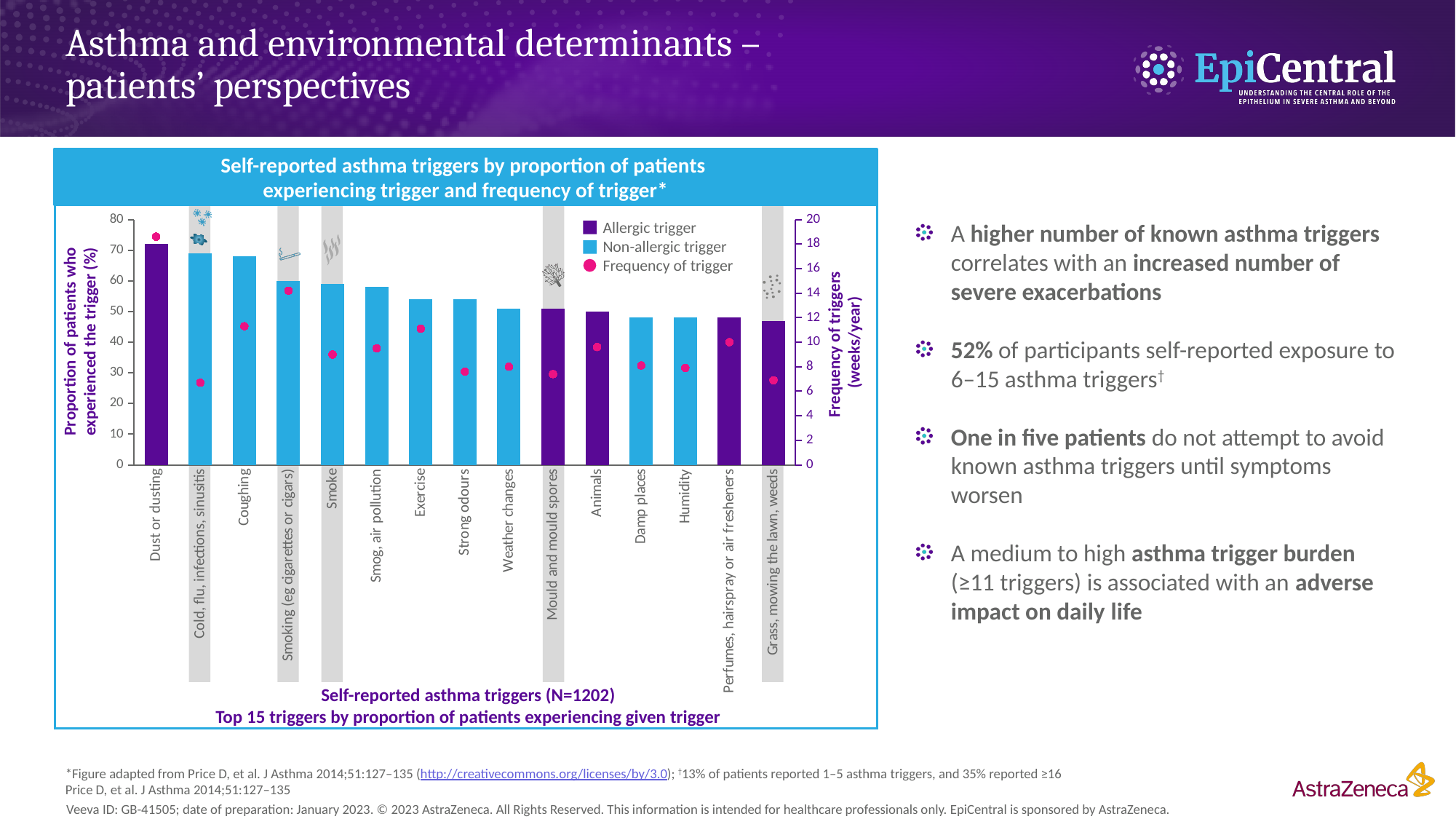
Do the bars for proportion of patients rise or fall from left to right across the triggers? Fall Is the frequency of trigger for Cold, flu, infections, sinusitis greater or less than 8 weeks/year? less How many entries does the chart legend list? 3 Is the proportion of patients for Grass, mowing the lawn, weeds greater or less than 50%? less Which trigger has the highest frequency of trigger (weeks/year)? Dust or dusting How many asthma triggers are shown on the x axis of the chart? 15 Which has a higher proportion of patients experiencing the trigger, Coughing or Exercise? Coughing Which colour does the legend use for allergic triggers? Purple What kind of chart is used to show the proportion of patients experiencing each trigger? Bar chart Is the frequency of trigger for Dust or dusting greater or less than 16 weeks/year? greater Which trigger has the highest proportion of patients who experienced it? Dust or dusting